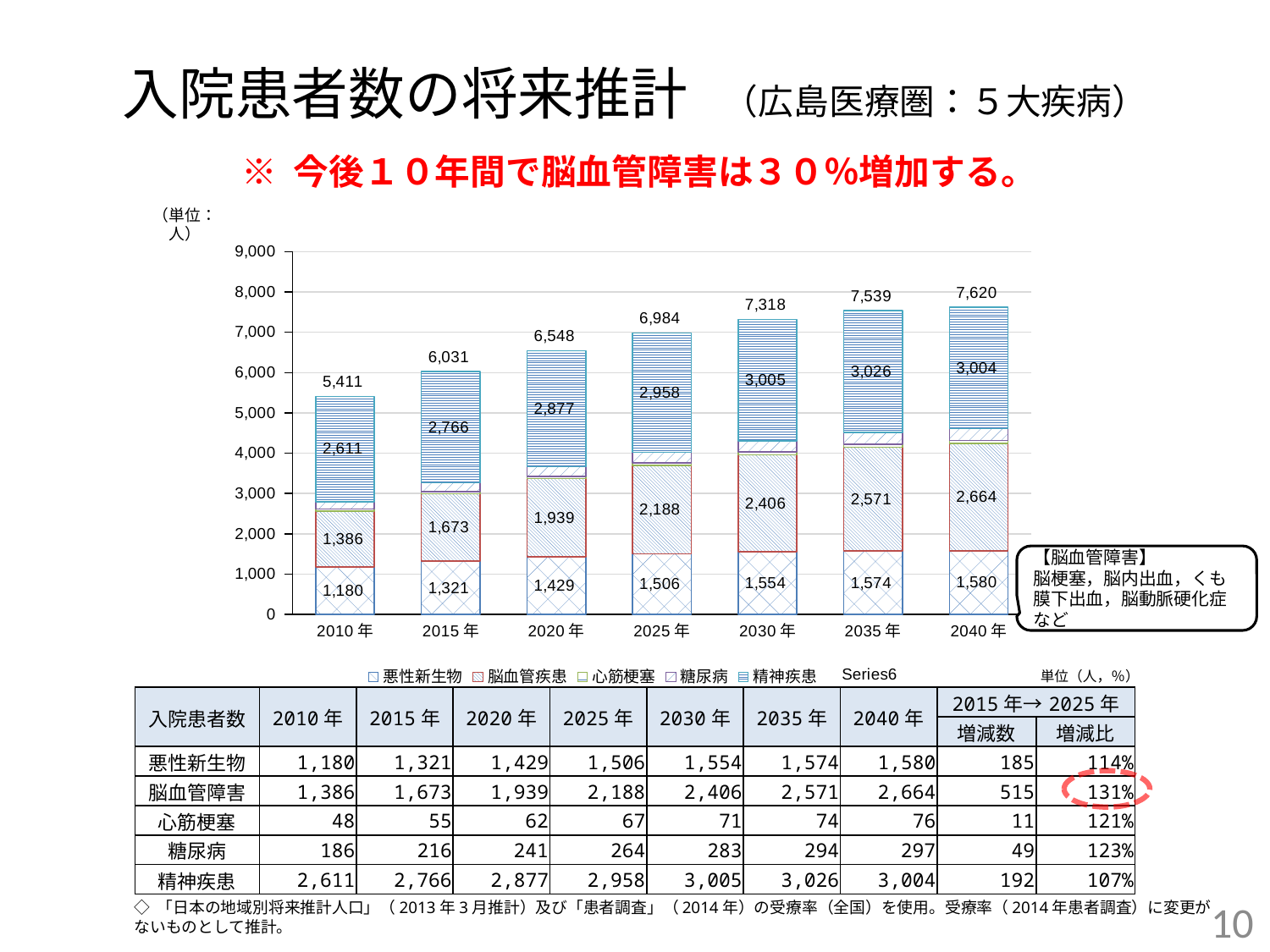
Which year has the lowest total stacked value? 2010年 What is the value of the 脳血管疾患 segment for 2025年? 2,188 What is the total stacked value for 2010年 shown above the bar? 5,411 What is the total stacked value for 2040年 shown above the bar? 7,620 How many years (categories) are shown on the x axis? 7 How many series does the legend list? 6 What is the value of the 悪性新生物 segment for 2020年? 1,429 What is the value of the 精神疾患 segment for 2035年? 3,026 Which is larger in 2030年, the 精神疾患 segment or the 脳血管疾患 segment? 精神疾患 What kind of chart is shown on the slide? Stacked bar chart Which year has the highest total stacked value? 2040年 What is the difference between the 脳血管疾患 values for 2040年 and 2010年? 1,278